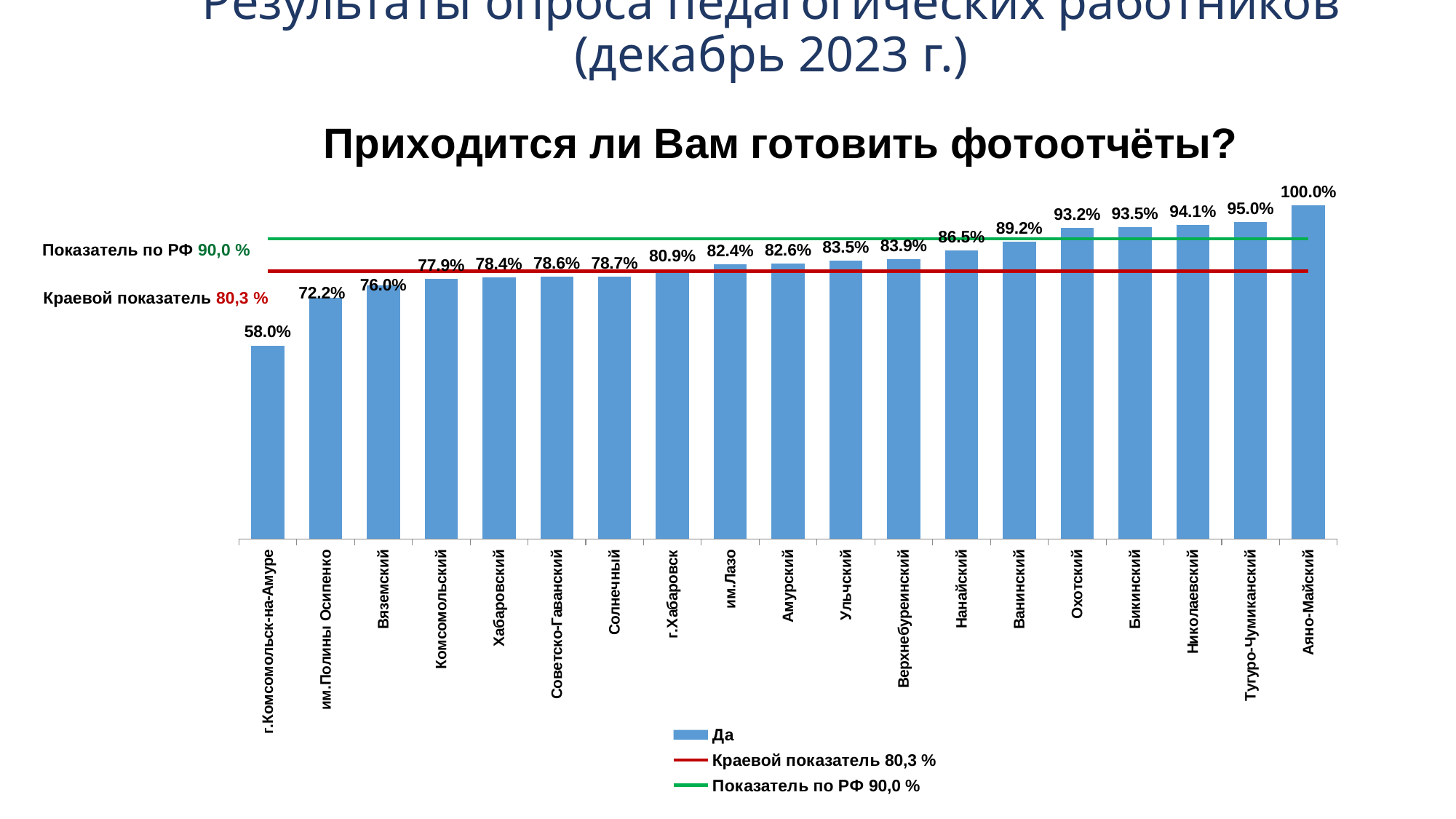
Which category has the highest value? Аяно-Майский What is the value for г.Хабаровск? 80.9% What is the value for Вяземский? 76.0% What type of chart is shown on the slide? bar chart What is the difference between the values for Охотский and Ванинский? 4.0% How many entries does the legend list? 3 Which is larger, the value for Ульчский or the value for им.Полины Осипенко? Ульчский What is the difference between the values for Аяно-Майский and г.Комсомольск-на-Амуре? 42.0% What value does the red reference line (Краевой показатель) represent? 80,3 % How many categories (districts) are shown on the x axis? 19 What is the value for Нанайский? 86.5% Which category has the lowest value? г.Комсомольск-на-Амуре